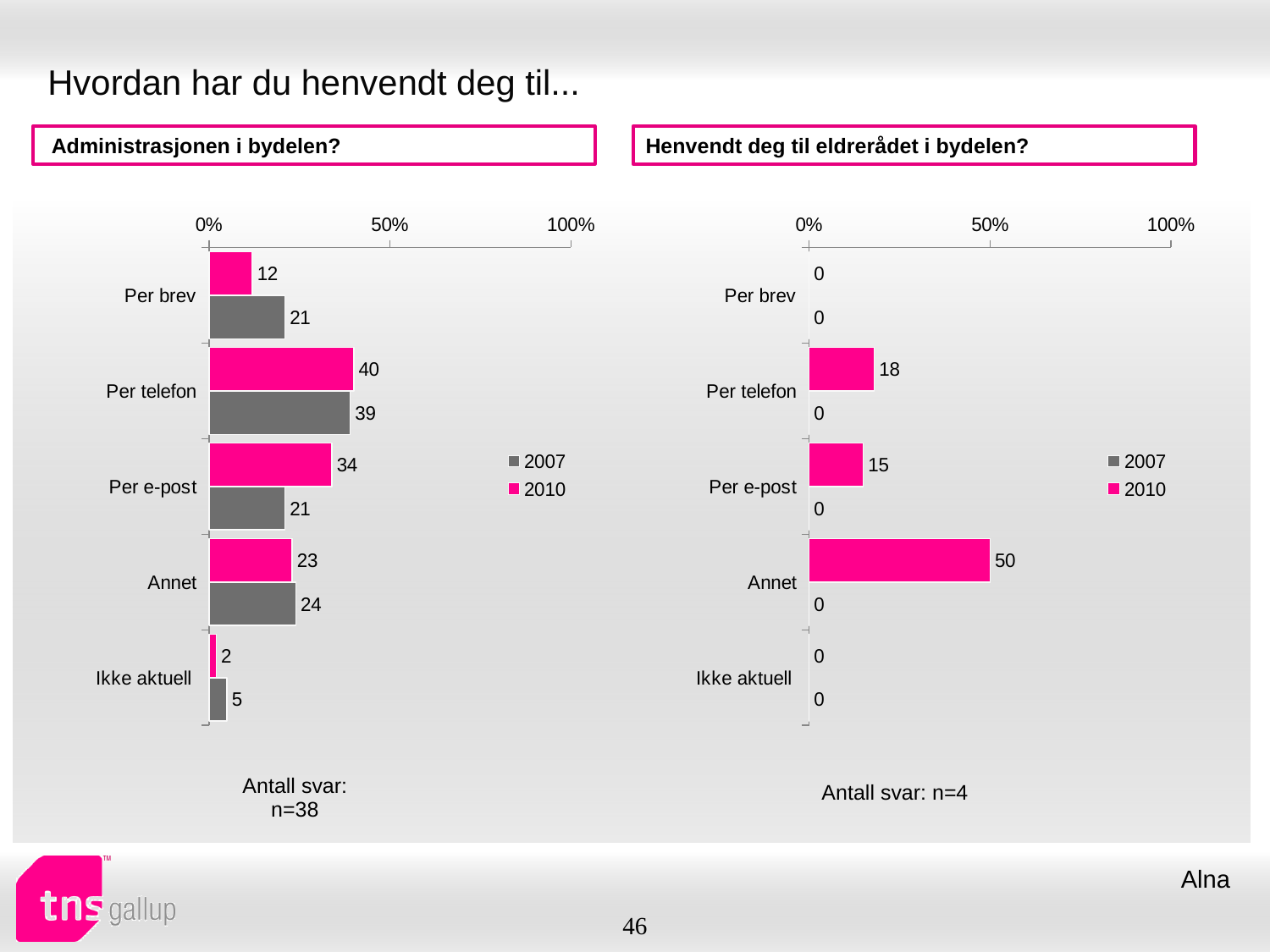
In the chart titled "Administrasjonen i bydelen?", which category has the highest value for 2010? Per telefon In the chart titled "Administrasjonen i bydelen?", is the 2010 value for Per brev larger or smaller than the 2007 value for Per brev? smaller In the chart titled "Administrasjonen i bydelen?", which category has the lowest value for 2007? Ikke aktuell How many categories are shown in the chart titled "Henvendt deg til eldrerådet i bydelen?"? 5 In the chart titled "Administrasjonen i bydelen?", what is the value for Per brev in 2007? 21 In the chart titled "Administrasjonen i bydelen?", what is the difference between the 2010 and 2007 values for Per e-post? 13 What kind of chart is the chart titled "Administrasjonen i bydelen?"? bar chart In the chart titled "Henvendt deg til eldrerådet i bydelen?", what is the value for Per telefon in 2007? 0 How many series does the legend list in the chart titled "Administrasjonen i bydelen?"? 2 In the chart titled "Henvendt deg til eldrerådet i bydelen?", which category has the highest value for 2010? Annet In the chart titled "Administrasjonen i bydelen?", what is the value for Per e-post in 2010? 34 In the chart titled "Henvendt deg til eldrerådet i bydelen?", what is the value for Annet in 2010? 50